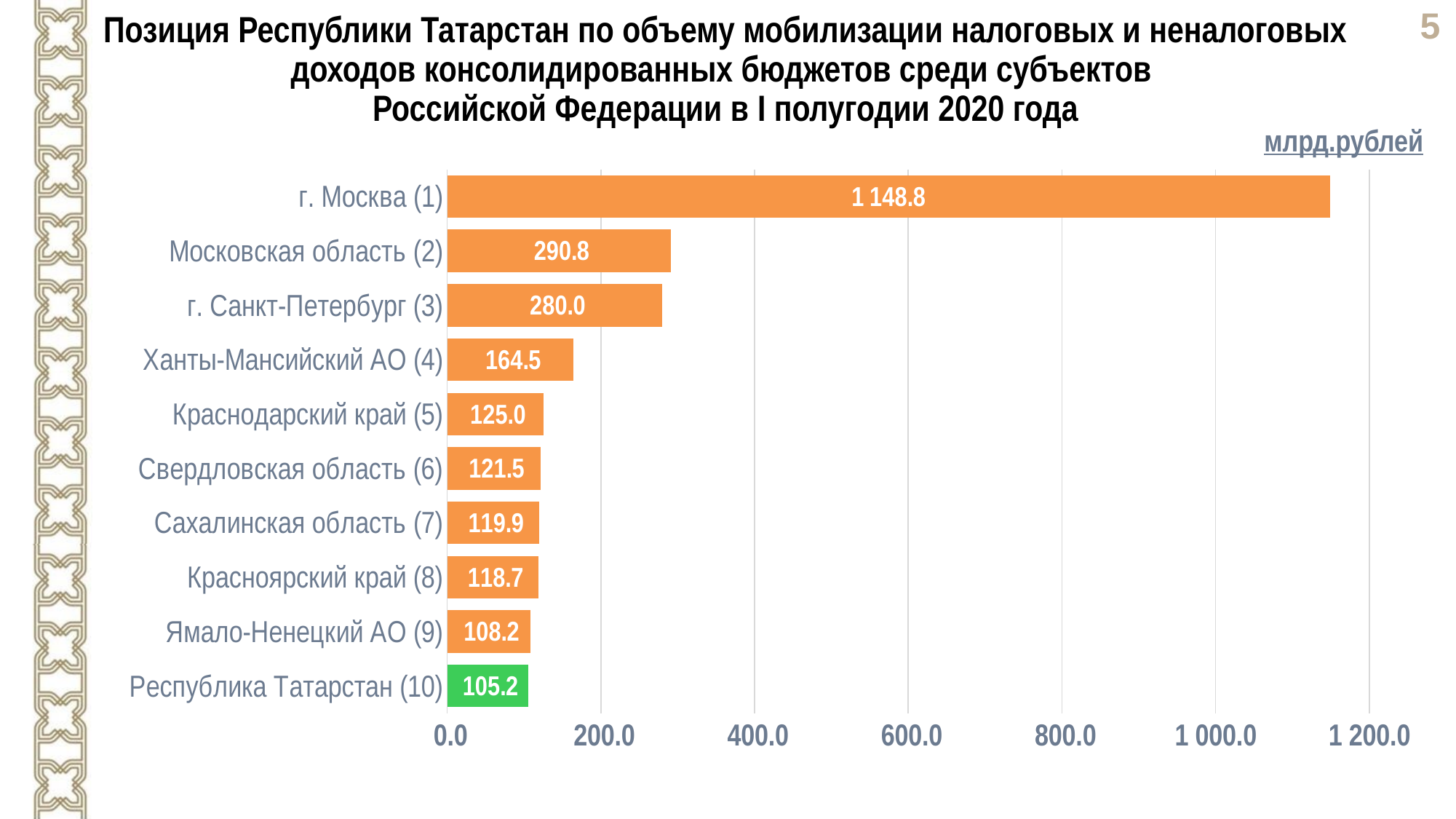
What is the value for Ханты-Мансийский АО (4)? 164.5 Which category has the lowest value? Республика Татарстан (10) What unit is indicated for the values in the chart? млрд.рублей Which is larger, the value for Краснодарский край (5) or Свердловская область (6)? Краснодарский край (5) What kind of chart is shown on the slide? bar chart Is the value for г. Санкт-Петербург (3) greater or less than 200.0? greater What is the value for г. Москва (1)? 1 148.8 How many categories are shown in the chart? 10 Which category has the highest value? г. Москва (1) Which bar is coloured green rather than orange? Республика Татарстан (10) What is the difference between the values for Московская область (2) and г. Санкт-Петербург (3)? 10.8 What is the value for Республика Татарстан (10)? 105.2